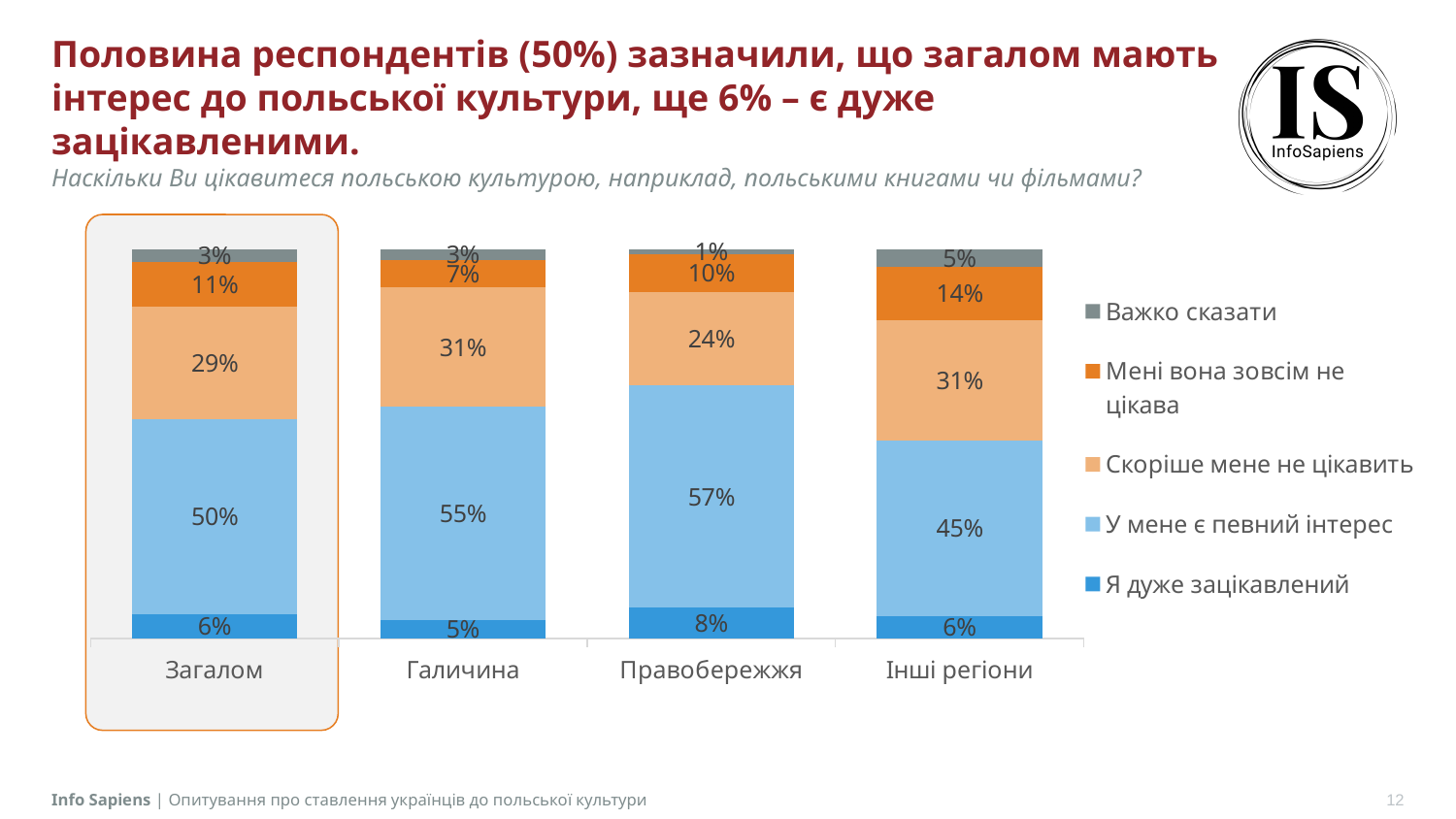
Which category has the highest value for "У мене є певний інтерес"? Правобережжя Which category has the lowest value for "Важко сказати"? Правобережжя What share of respondents in Інші регіони answered "Мені вона зовсім не цікава"? 14% Which is larger: the "Мені вона зовсім не цікава" value for Загалом or for Галичина? Загалом Which legend entry is shown in the darkest blue colour? Я дуже зацікавлений What is the value for "Скоріше мене не цікавить" in the Загалом bar? 29% What is the difference between the "У мене є певний інтерес" values for Галичина and Інші регіони? 10 percentage points What is the value for "Я дуже зацікавлений" in the Правобережжя bar? 8% How many series does the legend list? 5 What percentage of respondents in Галичина answered "У мене є певний інтерес"? 55% How many categories are shown on the x axis? 4 What kind of chart is shown on the slide? Stacked bar chart